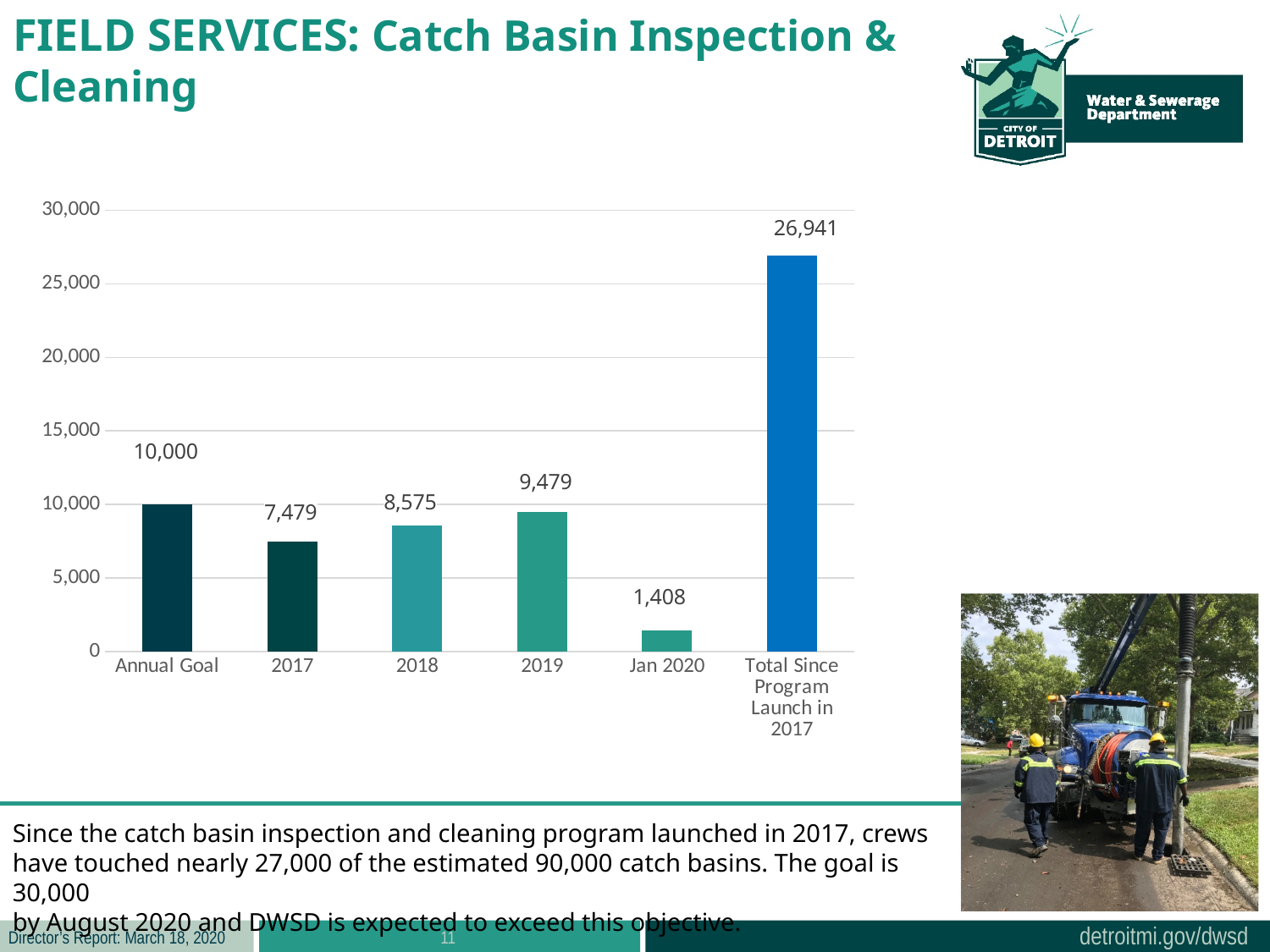
Do the values rise or fall from 2017 to 2019? rise What is the value for Jan 2020? 1,408 What kind of chart is shown on the slide? bar chart What is the value for Annual Goal? 10,000 What is the highest value labelled on the y axis? 30,000 Which category has the highest value? Total Since Program Launch in 2017 Which is larger, the value for 2018 or the value for 2019? 2019 What is the difference between the values for 2019 and 2017? 2,000 Which category has the lowest value? Jan 2020 What is the value for 2018? 8,575 Is the value for Total Since Program Launch in 2017 greater or less than 25,000? greater How many categories are shown on the x axis? 6